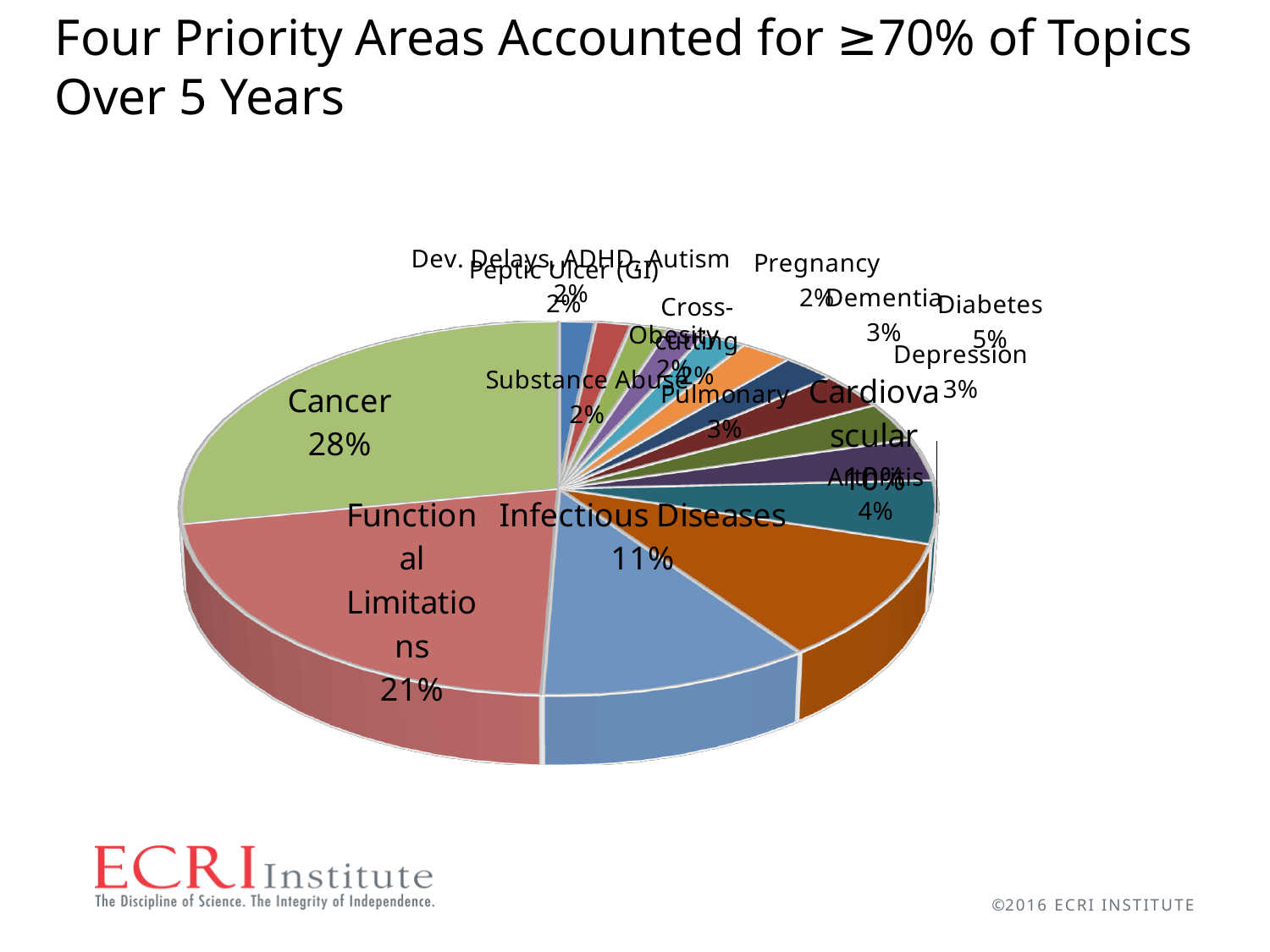
What percentage is shown for Cardiovascular? 10% What percentage is shown for Dementia? 3% Which category has the largest slice of the pie? Cancer What percentage is shown for Pregnancy? 2% What is the title of the slide containing the chart? Four Priority Areas Accounted for ≥70% of Topics Over 5 Years What percentage is shown for Diabetes? 5% What share of topics does the Cancer slice represent? 28% What kind of chart is shown on the slide? pie chart What percentage is shown for Functional Limitations? 21% What percentage is shown for Infectious Diseases? 11% What is the difference in percentage points between Cancer and Functional Limitations? 7 percentage points Which is larger, the share for Infectious Diseases or the share for Cardiovascular? Infectious Diseases